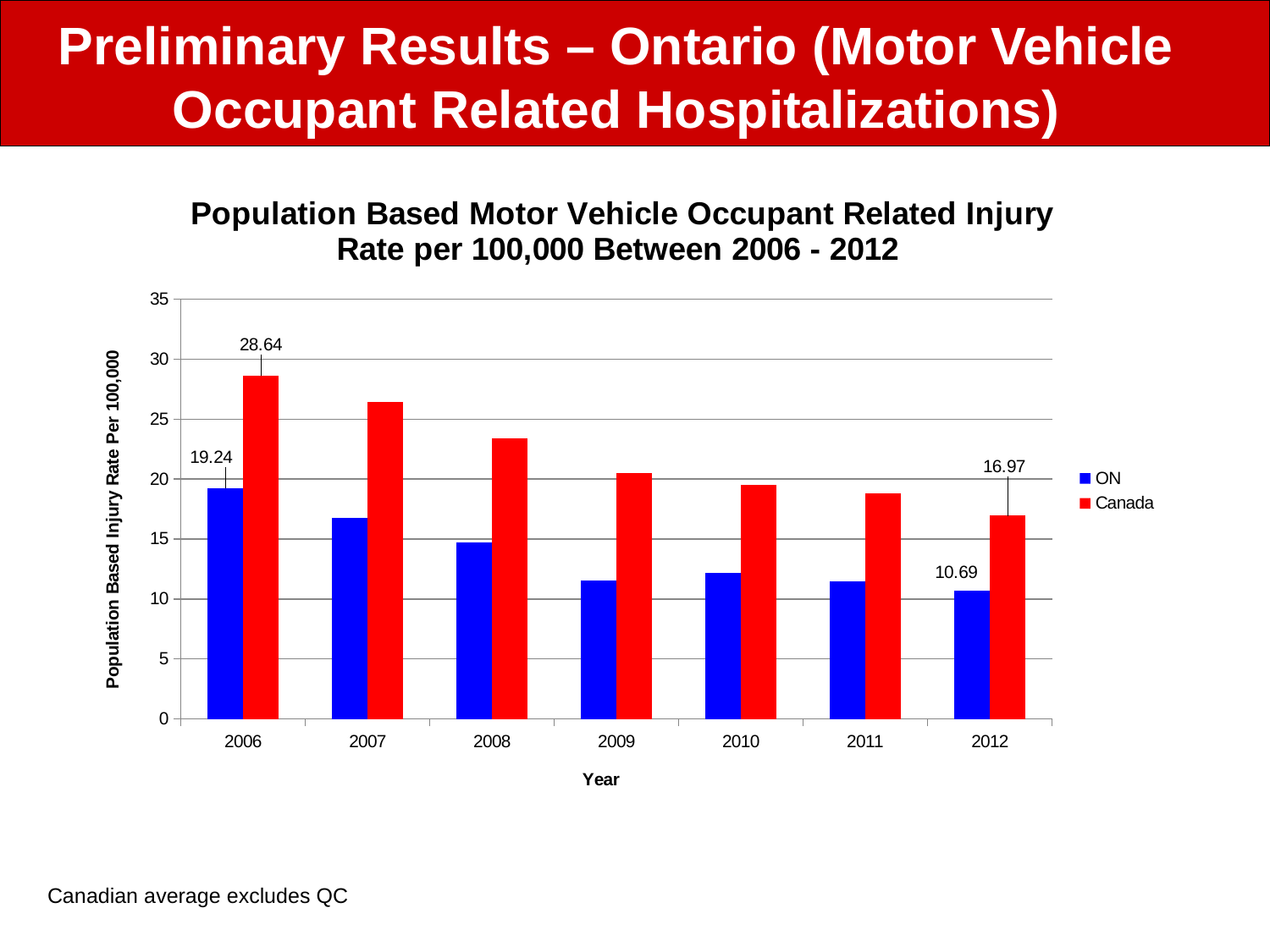
What is the Canada value for 2012? 16.97 What is the difference between the Canada and ON values in 2006? 9.40 What is the ON value for 2006? 19.24 Which year has the lowest ON value? 2012 What is the difference between the Canada and ON values in 2012? 6.28 What kind of chart is shown on the slide? bar chart What is the Canada value for 2006? 28.64 What is the ON value for 2012? 10.69 Is the Canada value for 2008 greater or less than 20? greater Which year has the highest Canada value? 2006 Is the ON value for 2009 greater or less than 15? less How many series does the legend list? 2